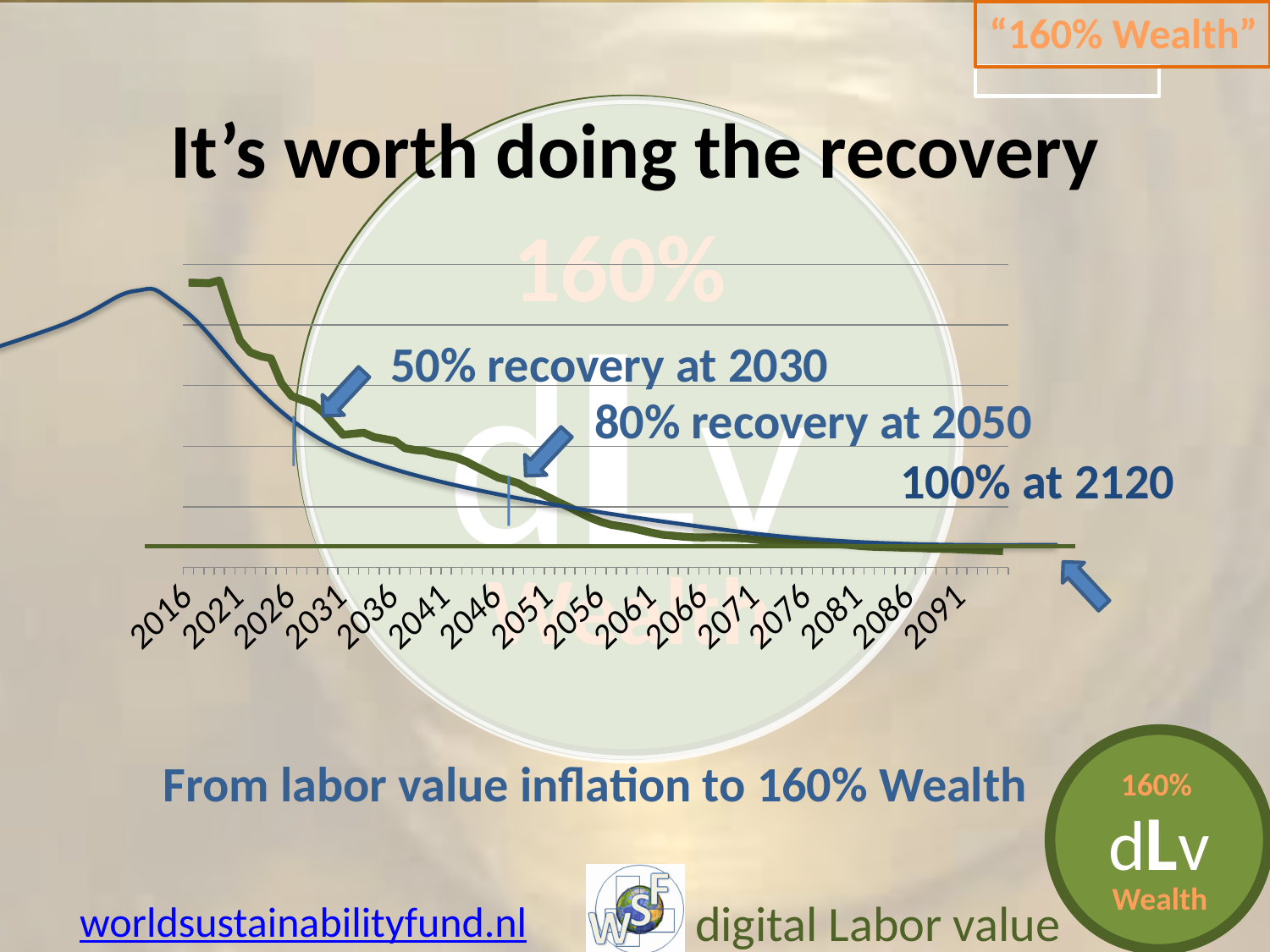
What is the last year label on the x axis of the chart? 2091 According to the annotation on the chart, in which year is 50% recovery reached? 2030 At 2026, which line is higher, the green line or the blue line? green line How many year labels are shown along the x axis of the chart? 16 According to the annotation on the chart, in which year is 100% recovery reached? 2120 According to the annotation on the chart, what level of recovery is reached at 2050? 80% At 2036, which line is higher, the green line or the blue line? green line Do the plotted lines generally rise or fall from 2021 to 2091? fall Does the green line rise or fall between 2021 and 2051? fall What kind of chart is shown on the slide? line chart How many lines are plotted on the chart? 2 What is the first year label on the x axis of the chart? 2016